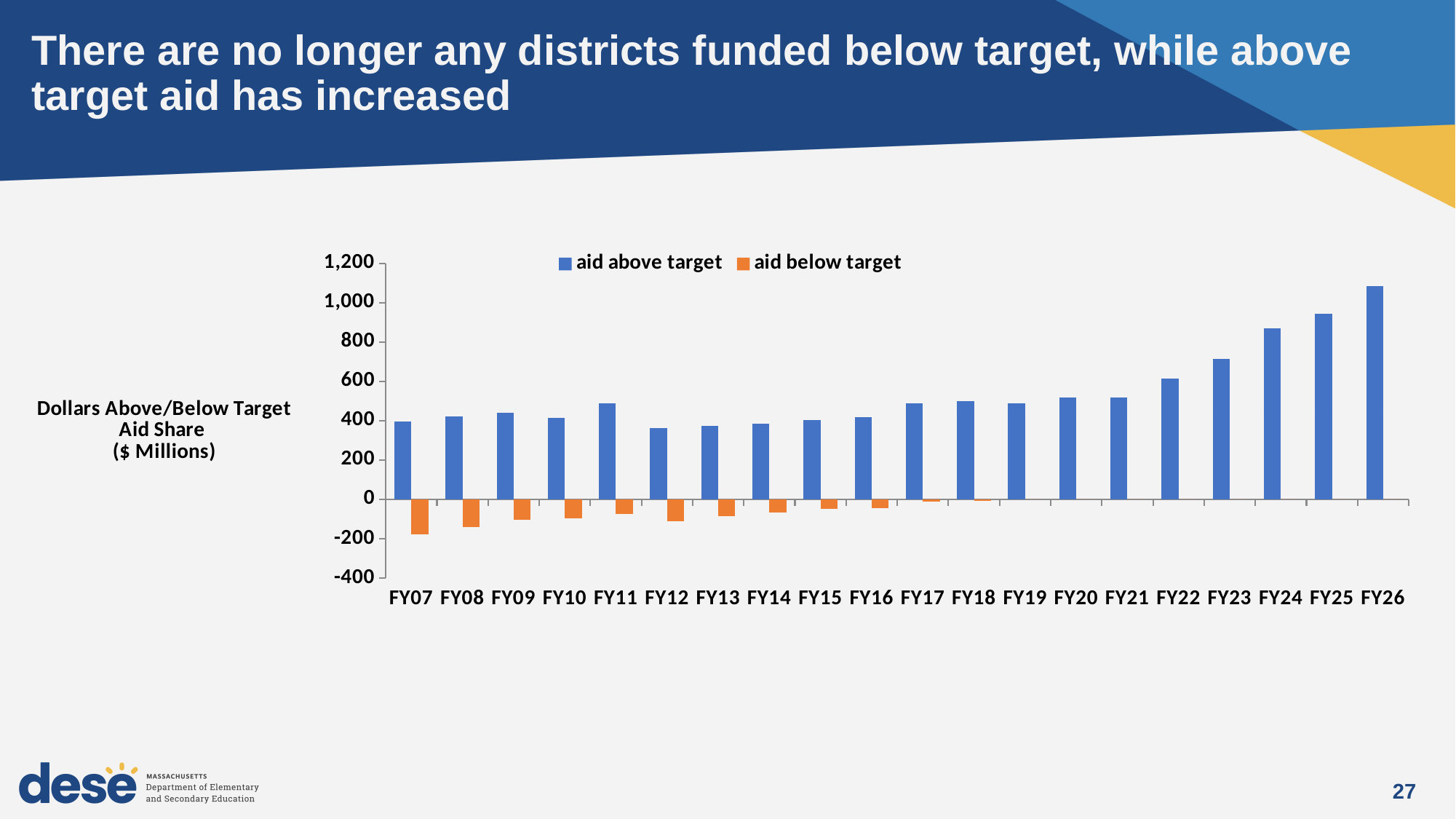
How many series does the legend list? 2 Is the value for aid above target in FY24 greater or less than 800? greater Which fiscal year has the largest amount of aid below target (the most negative bar)? FY07 Does aid above target rise or fall from FY21 to FY26? Rises Is the value for aid above target in FY26 greater or less than 1,000? greater Which fiscal year has the highest aid above target? FY26 What is the label on the vertical axis of the chart? Dollars Above/Below Target Aid Share ($ Millions) Which has the larger aid above target, FY20 or FY25? FY25 What colour represents aid below target in the legend? Orange How many fiscal years are shown on the x axis? 20 What kind of chart is shown on the slide? Bar chart Is the value for aid below target in FY07 greater or less than -100? less